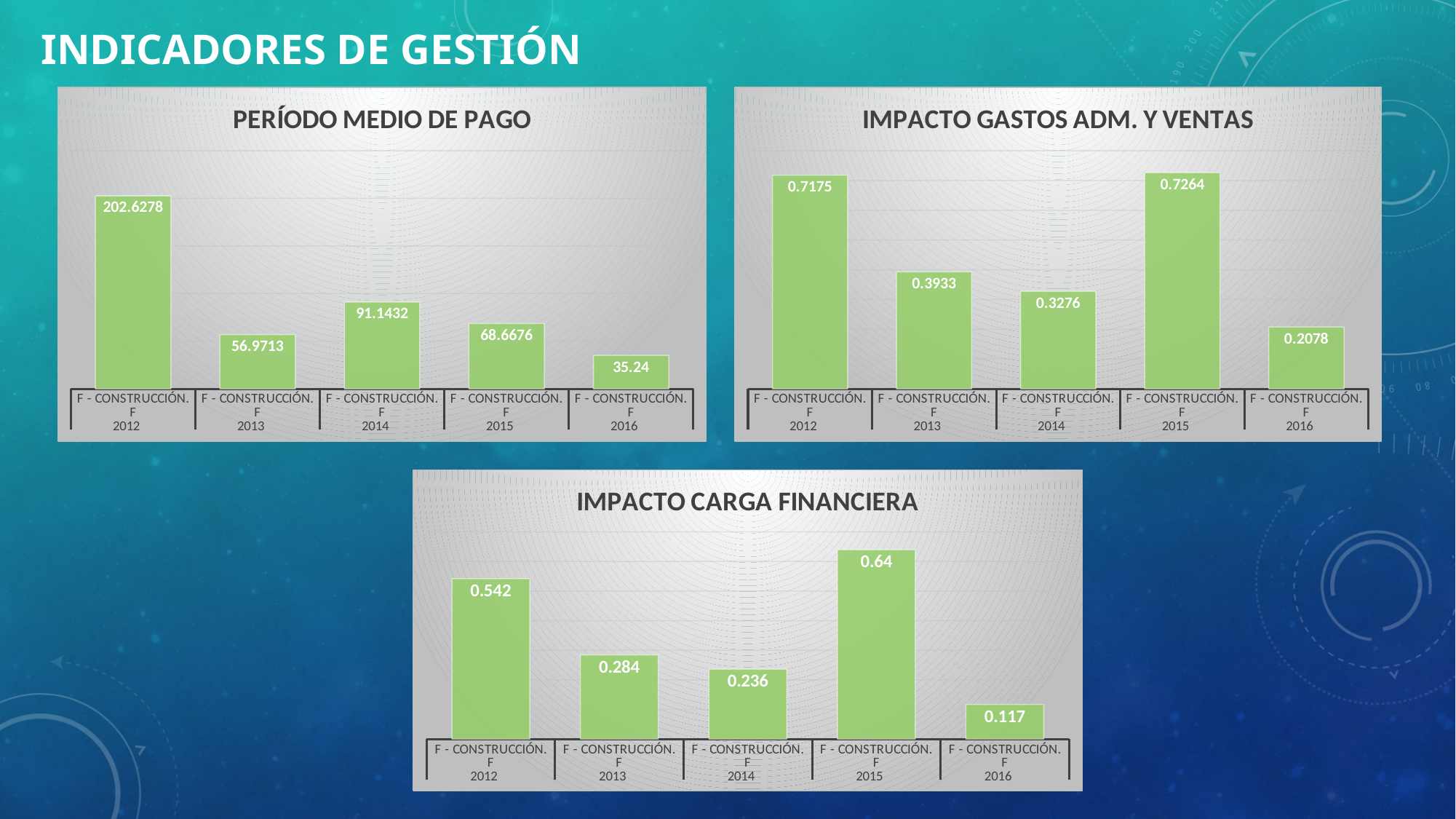
In the 'IMPACTO GASTOS ADM. Y VENTAS' chart, what is the value for 2015? 0.7264 In the 'IMPACTO CARGA FINANCIERA' chart, which year has the highest value? 2015 In the 'IMPACTO GASTOS ADM. Y VENTAS' chart, which year has the highest value? 2015 How many bars are shown in the 'IMPACTO CARGA FINANCIERA' chart? 5 In the 'IMPACTO CARGA FINANCIERA' chart, what is the value for 2016? 0.117 In the 'IMPACTO GASTOS ADM. Y VENTAS' chart, which is larger, the value for 2013 or the value for 2014? 2013 In the 'IMPACTO CARGA FINANCIERA' chart, what is the difference between the 2015 and 2012 values? 0.098 In the 'PERÍODO MEDIO DE PAGO' chart, what is the value for 2012? 202.6278 In the 'PERÍODO MEDIO DE PAGO' chart, what is the difference between the 2014 and 2013 values? 34.1719 How many charts are shown on the slide? 3 In the 'PERÍODO MEDIO DE PAGO' chart, which year has the lowest value? 2016 What type of chart is 'PERÍODO MEDIO DE PAGO'? Bar chart